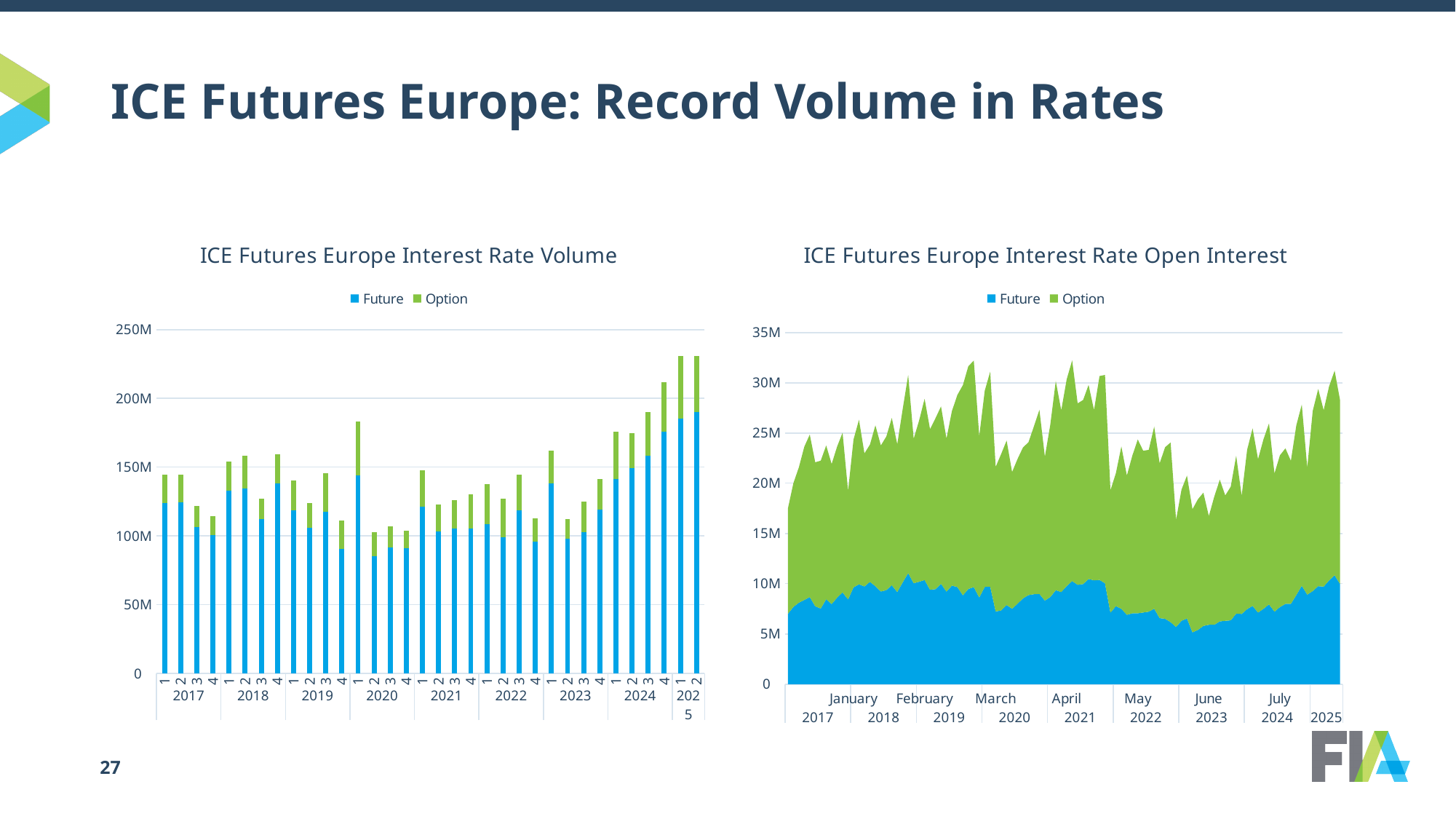
In the ICE Futures Europe Interest Rate Open Interest chart, is the total open interest at the start of 2017 greater or less than 20M? less What kind of chart is the ICE Futures Europe Interest Rate Open Interest chart on the right? Area chart What is the title of the chart on the right of the slide? ICE Futures Europe Interest Rate Open Interest In the ICE Futures Europe Interest Rate Volume chart, do the total bars rise or fall from quarter 1 of 2023 to quarter 2 of 2025? Rise In the ICE Futures Europe Interest Rate Volume chart, which total bar is larger: quarter 4 of 2024 or quarter 1 of 2017? Quarter 4 of 2024 In the ICE Futures Europe Interest Rate Volume chart, is the total bar for quarter 2 of 2020 greater or less than 150M? less In the ICE Futures Europe Interest Rate Volume chart, is the total bar for quarter 1 of 2025 greater or less than 200M? greater How many series does the legend of the ICE Futures Europe Interest Rate Volume chart list? 2 In the ICE Futures Europe Interest Rate Open Interest chart, which series is shown in green? Option What kind of chart is the ICE Futures Europe Interest Rate Volume chart on the left? Bar chart How many years are labelled on the x axis of the ICE Futures Europe Interest Rate Volume chart? 9